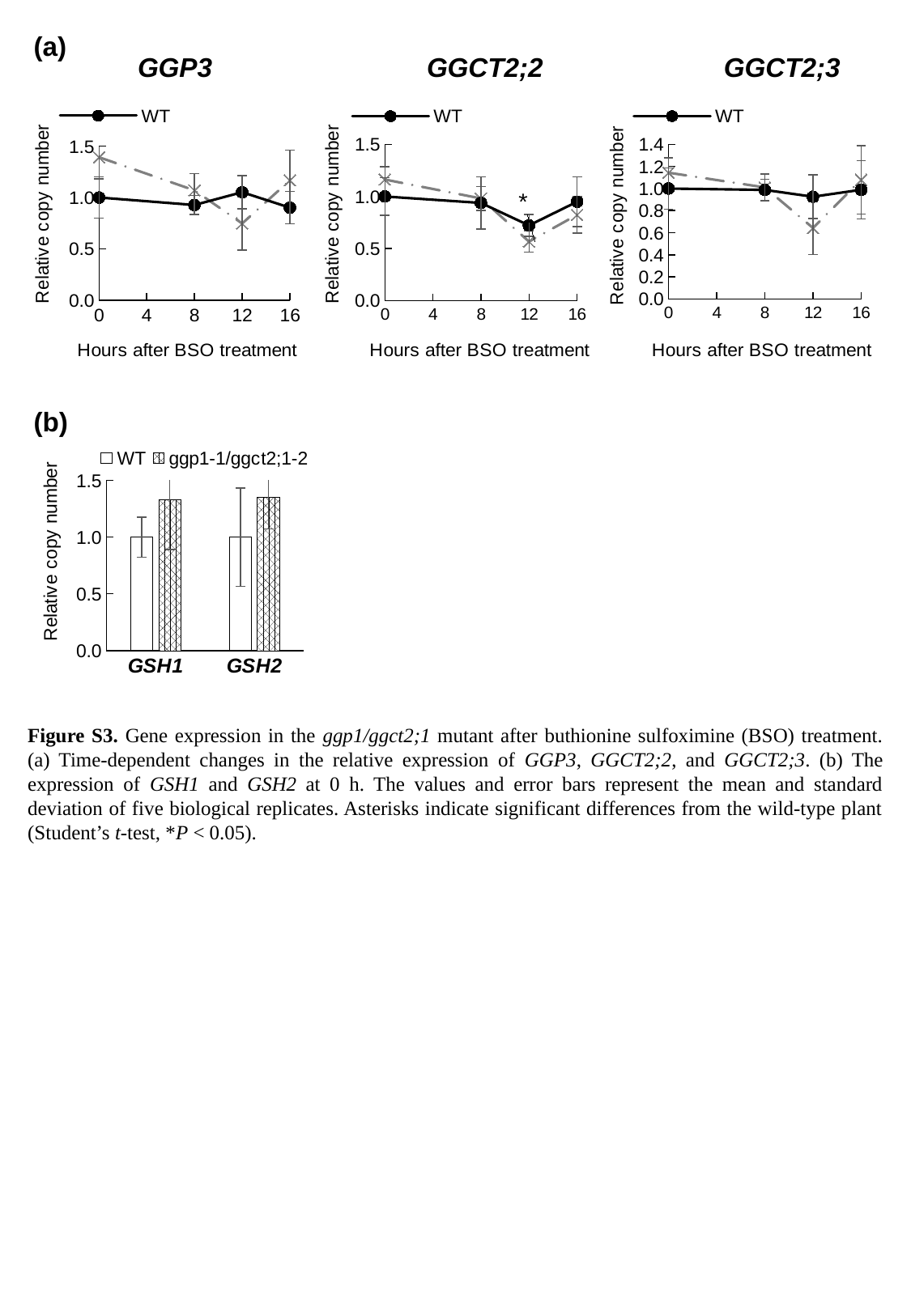
What kind of chart is the GGP3 chart? line chart In the GGCT2;2 chart, at which time point is the WT value lowest? 12 What kind of chart is the chart in panel (b)? bar chart In the chart in panel (b), is the ggp1-1/ggct2;1-2 bar for GSH1 greater or less than 1.0? greater In the GGP3 chart, is the value of the dashed (mutant) line at 0 hours greater or less than 1.0? greater In the GGCT2;2 chart, how many time points are plotted along the x axis? 4 In the chart in panel (b), how many gene categories are shown on the x axis? 2 What is the x-axis title of the GGCT2;3 chart? Hours after BSO treatment In the chart in panel (b), how many series does the legend list? 2 In the GGCT2;3 chart, is the value of the dashed (mutant) line at 12 hours greater or less than 1.0? less In the chart in panel (b), which bar is taller for GSH2, WT or ggp1-1/ggct2;1-2? ggp1-1/ggct2;1-2